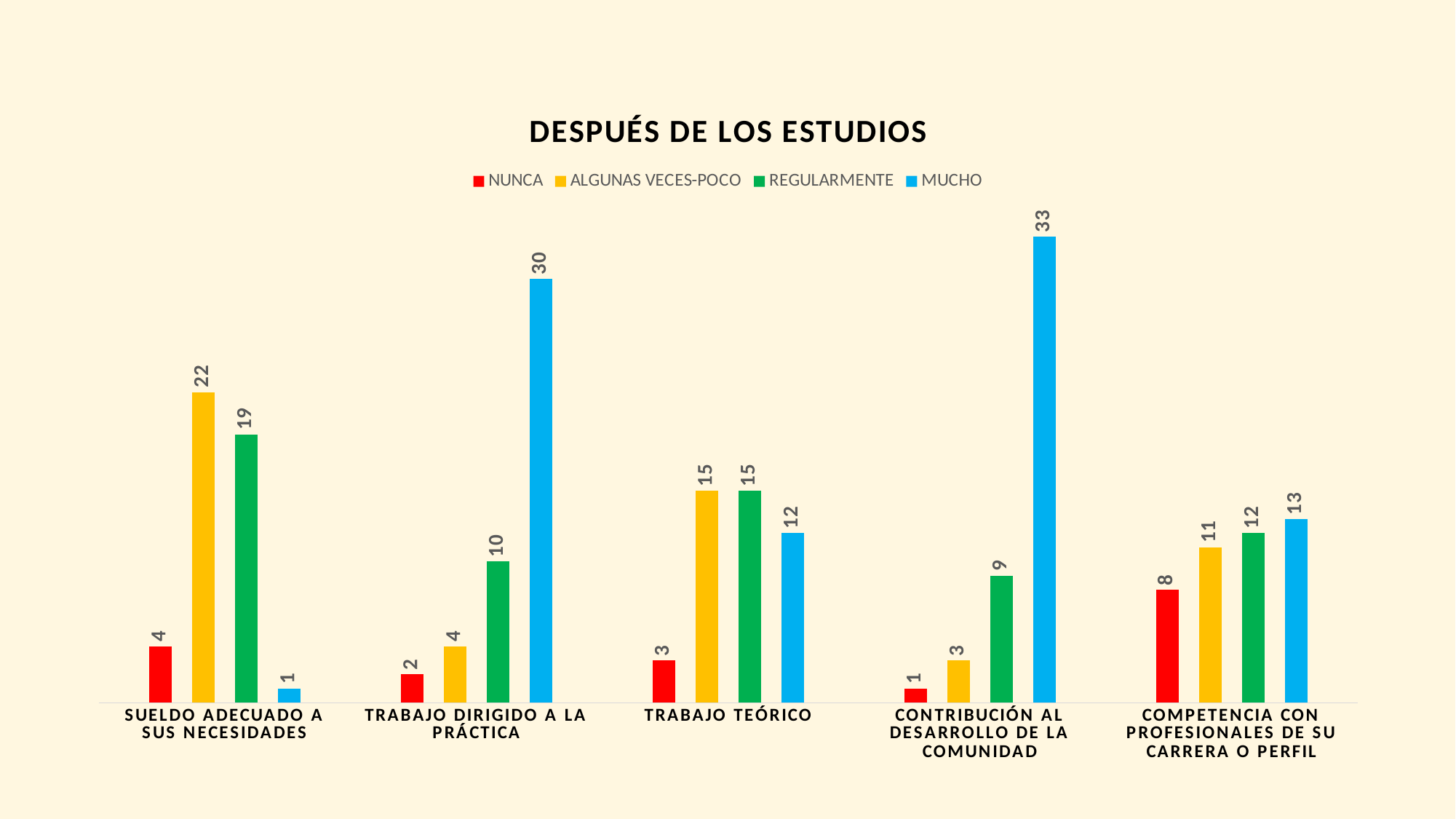
How many series does the legend list? 4 Which category has the highest value for MUCHO? CONTRIBUCIÓN AL DESARROLLO DE LA COMUNIDAD What kind of chart is shown on the slide? Bar chart How many categories are shown on the x axis? 5 Which is larger in the SUELDO ADECUADO A SUS NECESIDADES category: ALGUNAS VECES-POCO or REGULARMENTE? ALGUNAS VECES-POCO What is the value for ALGUNAS VECES-POCO in the SUELDO ADECUADO A SUS NECESIDADES category? 22 What colour represents the MUCHO series? Blue What is the difference between the MUCHO value and the REGULARMENTE value in the TRABAJO DIRIGIDO A LA PRÁCTICA category? 20 What is the value for MUCHO in the CONTRIBUCIÓN AL DESARROLLO DE LA COMUNIDAD category? 33 Which category has the lowest value for NUNCA? CONTRIBUCIÓN AL DESARROLLO DE LA COMUNIDAD What is the title of the chart? DESPUÉS DE LOS ESTUDIOS What is the value for NUNCA in the COMPETENCIA CON PROFESIONALES DE SU CARRERA O PERFIL category? 8